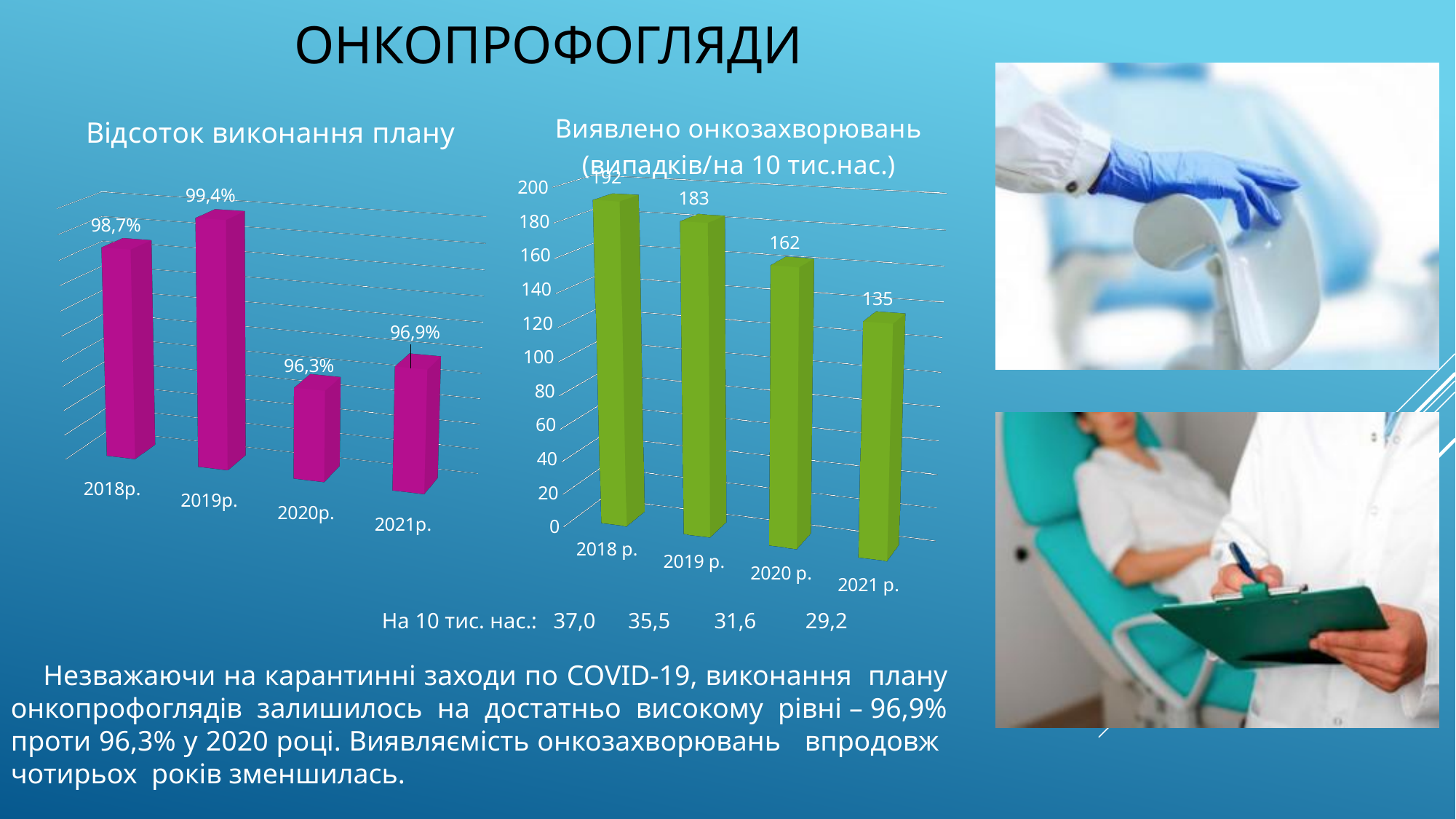
In the chart titled "Виявлено онкозахворювань", what is the value for 2018 р.? 192 In the chart titled "Відсоток виконання плану", which year has the highest value? 2019р. What type of chart is the chart titled "Виявлено онкозахворювань"? bar chart In the chart titled "Виявлено онкозахворювань", what is the value for 2020 р.? 162 In the chart titled "Виявлено онкозахворювань", what is the difference between the values for 2018 р. and 2021 р.? 57 In the chart titled "Виявлено онкозахворювань", which year has the lowest value? 2021 р. In the chart titled "Відсоток виконання плану", what is the value for 2019р.? 99,4% In the chart titled "Виявлено онкозахворювань", do the values rise or fall from 2018 р. to 2021 р.? fall In the chart titled "Відсоток виконання плану", which year has the lowest value? 2020р. In the chart titled "Відсоток виконання плану", what is the value for 2021р.? 96,9% In the chart titled "Відсоток виконання плану", how many bars are plotted? 4 In the chart titled "Виявлено онкозахворювань", is the value for 2019 р. greater or less than 180? greater